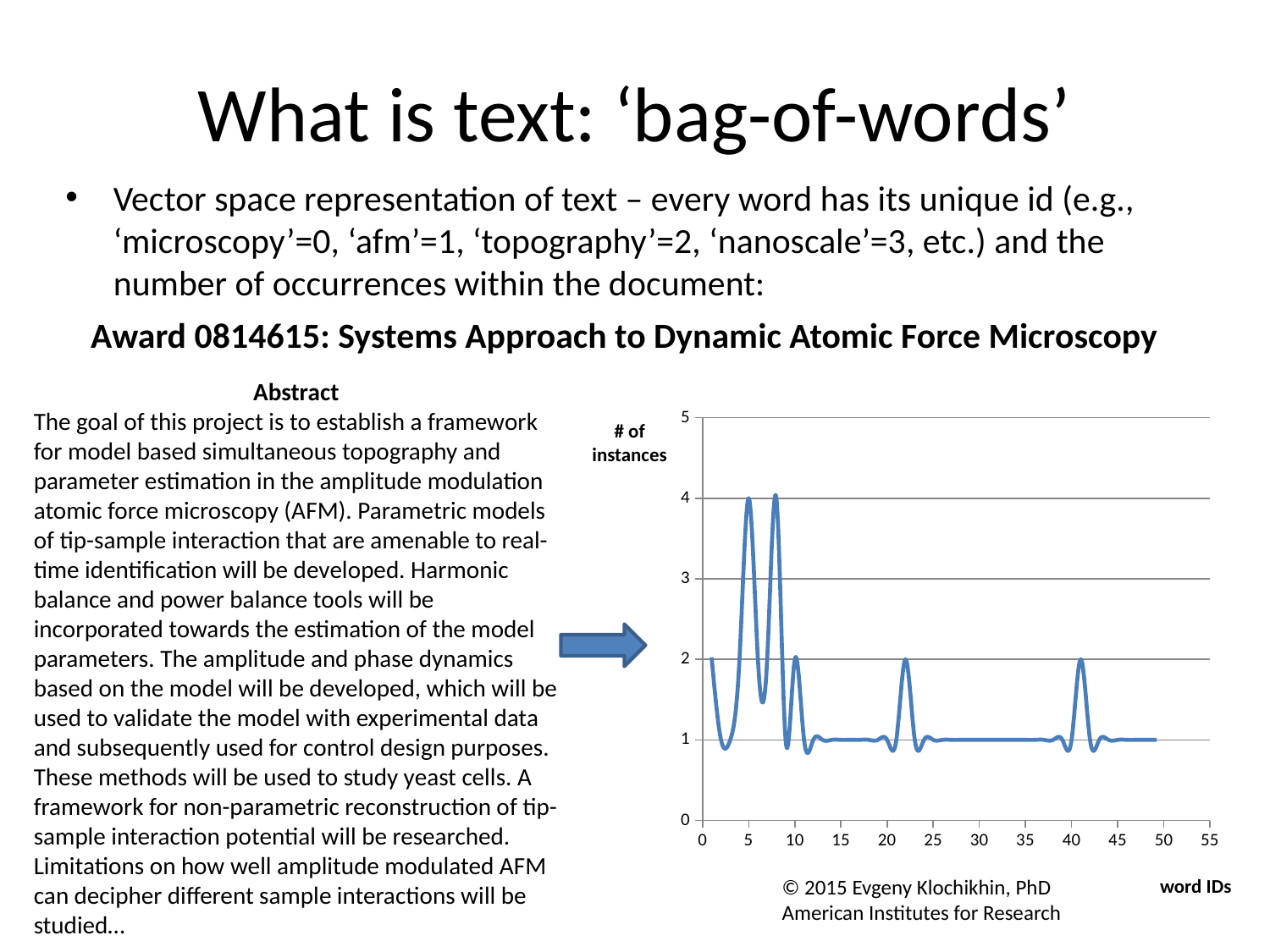
Is the number of instances at word ID 45 greater or less than 3? less Is the peak number of instances near word ID 5 greater or less than 3? greater What is the label of the horizontal axis of the chart? word IDs What kind of chart is shown on the slide? line chart What is the highest tick value shown on the vertical axis of the chart? 5 Is the number of instances at word ID 15 greater or less than 2? less What is the highest tick value shown on the horizontal axis of the chart? 55 What is the label of the vertical axis of the chart? # of instances What is the highest number of instances reached by the line in the chart? 4 Which is larger: the number of instances at the peak near word ID 5 or at the peak near word ID 22? the peak near word ID 5